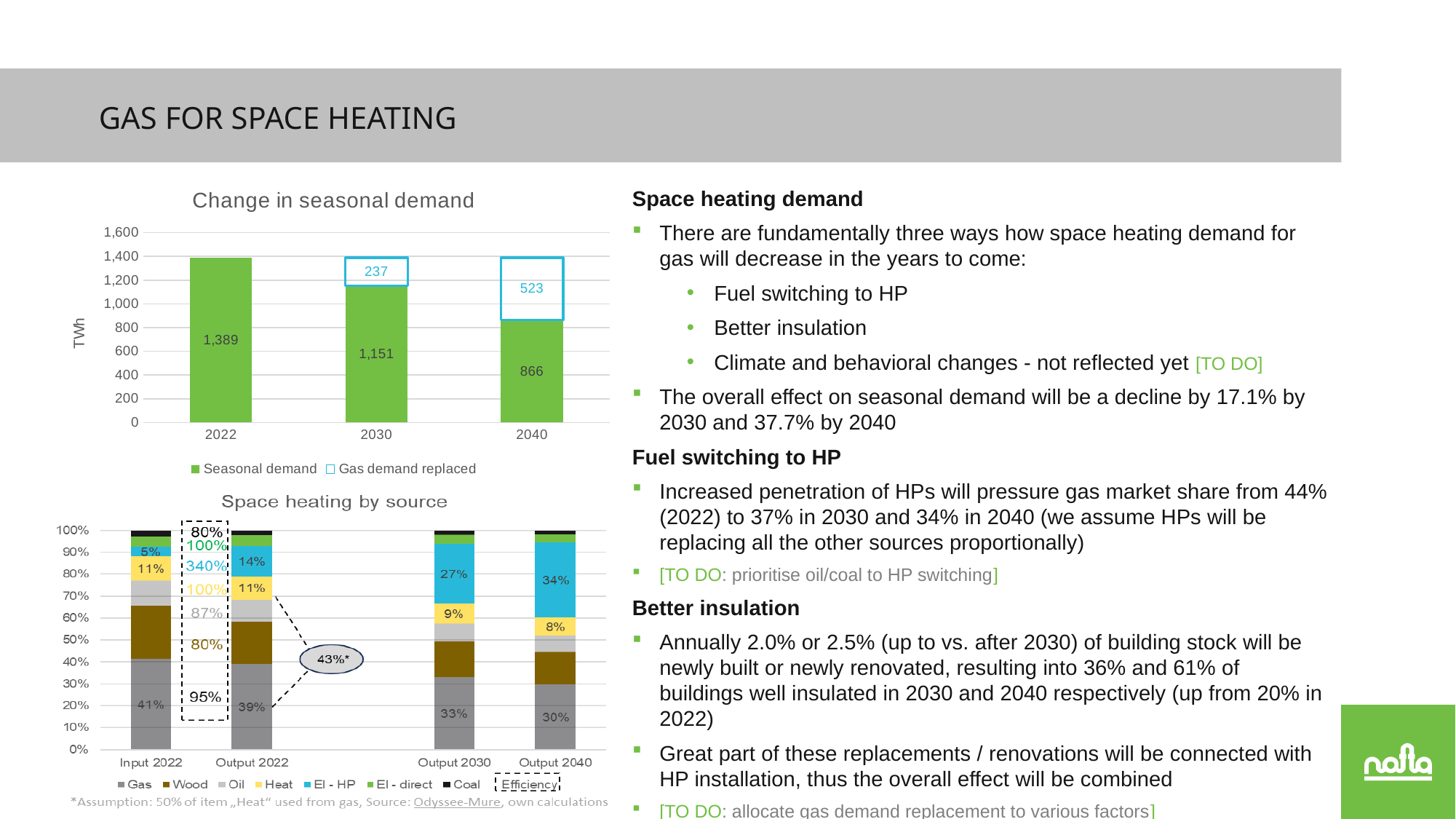
In the 'Space heating by source' chart, what is the El - HP share for Output 2030? 27% In the 'Change in seasonal demand' chart, does seasonal demand rise or fall from 2022 to 2040? fall In the 'Change in seasonal demand' chart, what is the total of the stacked bar for 2030 (seasonal demand plus gas demand replaced)? 1,388 In the 'Space heating by source' chart, which is larger for Output 2022: the Gas share or the El - HP share? Gas In the 'Change in seasonal demand' chart, what is the difference between the seasonal demand in 2022 and in 2040? 523 What kind of chart is 'Space heating by source'? stacked bar chart In the 'Change in seasonal demand' chart, which year has the lowest seasonal demand? 2040 In the 'Change in seasonal demand' chart, what is the seasonal demand value for 2022? 1,389 In the 'Change in seasonal demand' chart, what is the seasonal demand value for 2030? 1,151 In the 'Space heating by source' chart, what is the Gas share for Output 2040? 30% In the 'Change in seasonal demand' chart, how many series does the legend list? 2 In the 'Change in seasonal demand' chart, what is the gas demand replaced value for 2040? 523